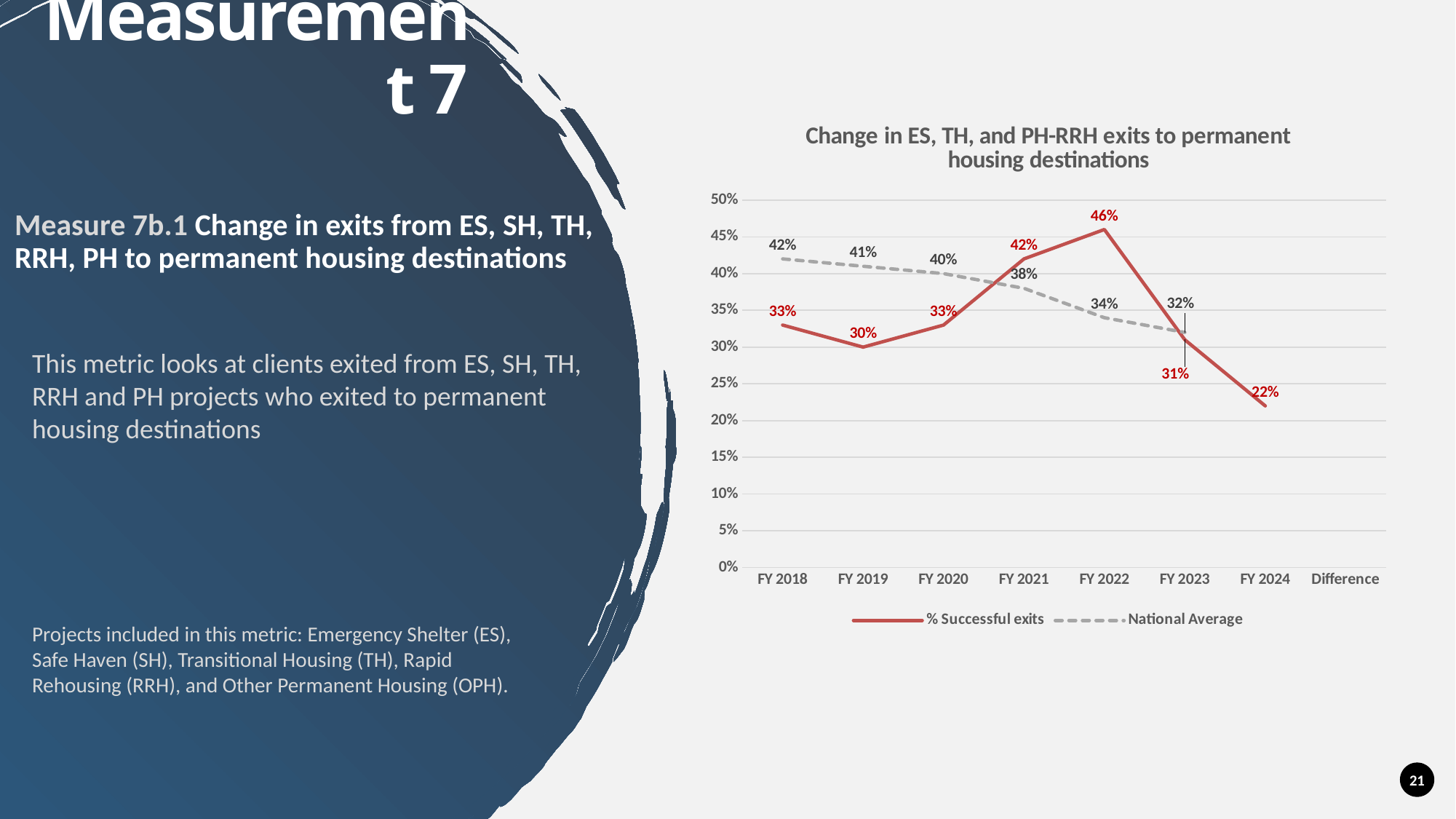
How many series does the legend list? 2 What is the % Successful exits value for FY 2024? 22% What is the % Successful exits value for FY 2022? 46% What is the National Average value for FY 2020? 40% What type of chart is shown on the slide? Line chart In which fiscal year is the % Successful exits value highest? FY 2022 Does the National Average rise or fall from FY 2018 to FY 2023? Fall What is the title of the chart? Change in ES, TH, and PH-RRH exits to permanent housing destinations How many fiscal years are labelled on the x axis? 7 What is the difference between the National Average and % Successful exits in FY 2018? 9% In which fiscal year is the % Successful exits value lowest? FY 2024 Which is larger in FY 2021, % Successful exits or National Average? % Successful exits